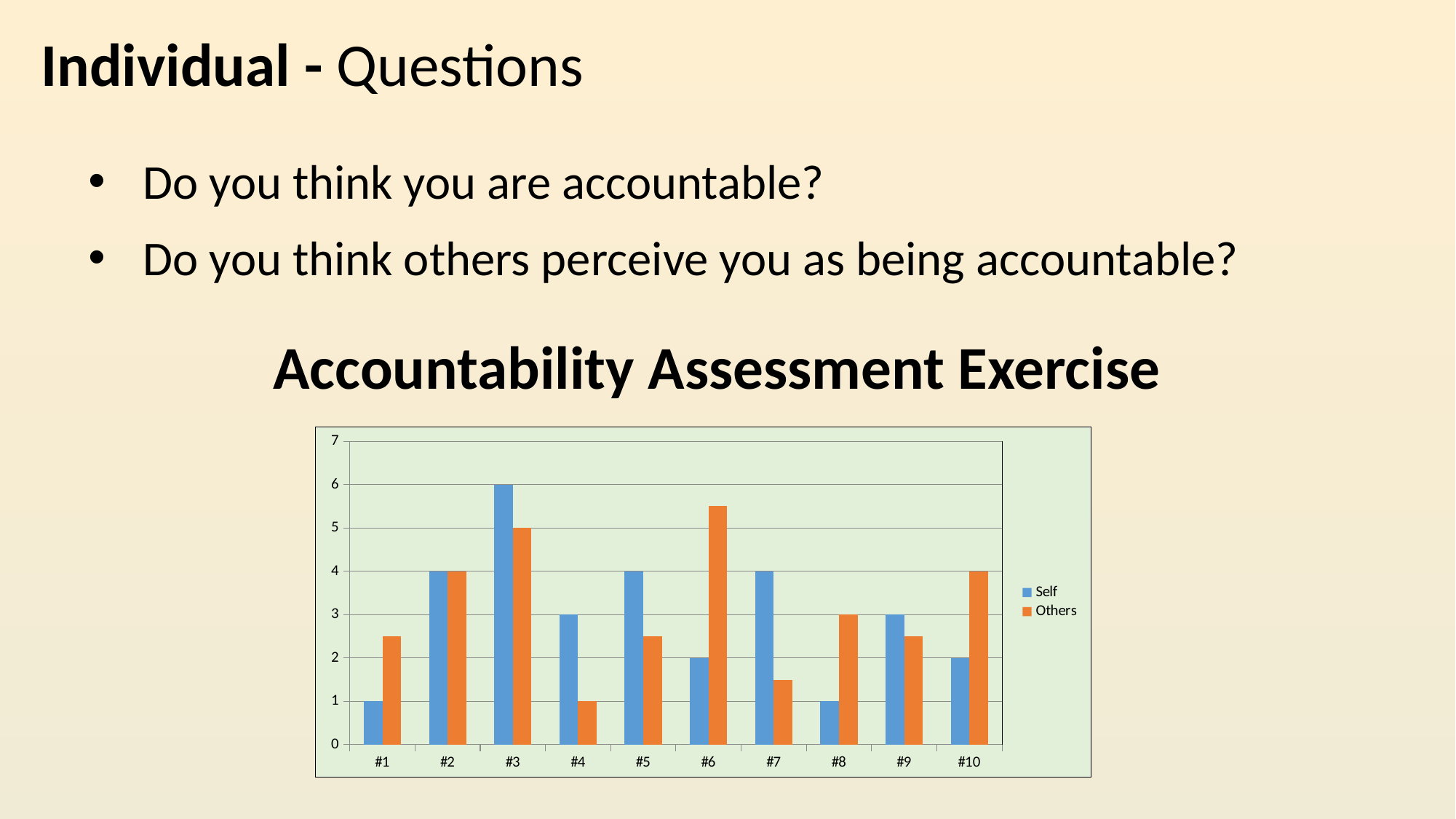
Which category has the highest Self value? #3 What is the Others value for #4? 1 What type of chart is shown on the slide? bar chart Which category has the highest Others value? #6 How many categories are shown on the x axis? 10 What is the Self value for #3? 6 Which category has the lowest Others value? #4 Is the Others value for #6 greater or less than 5? greater How many series does the legend list? 2 For #7, which is larger, the Self value or the Others value? Self What is the Self value for #8? 1 What is the difference between the Self and Others values for #3? 1